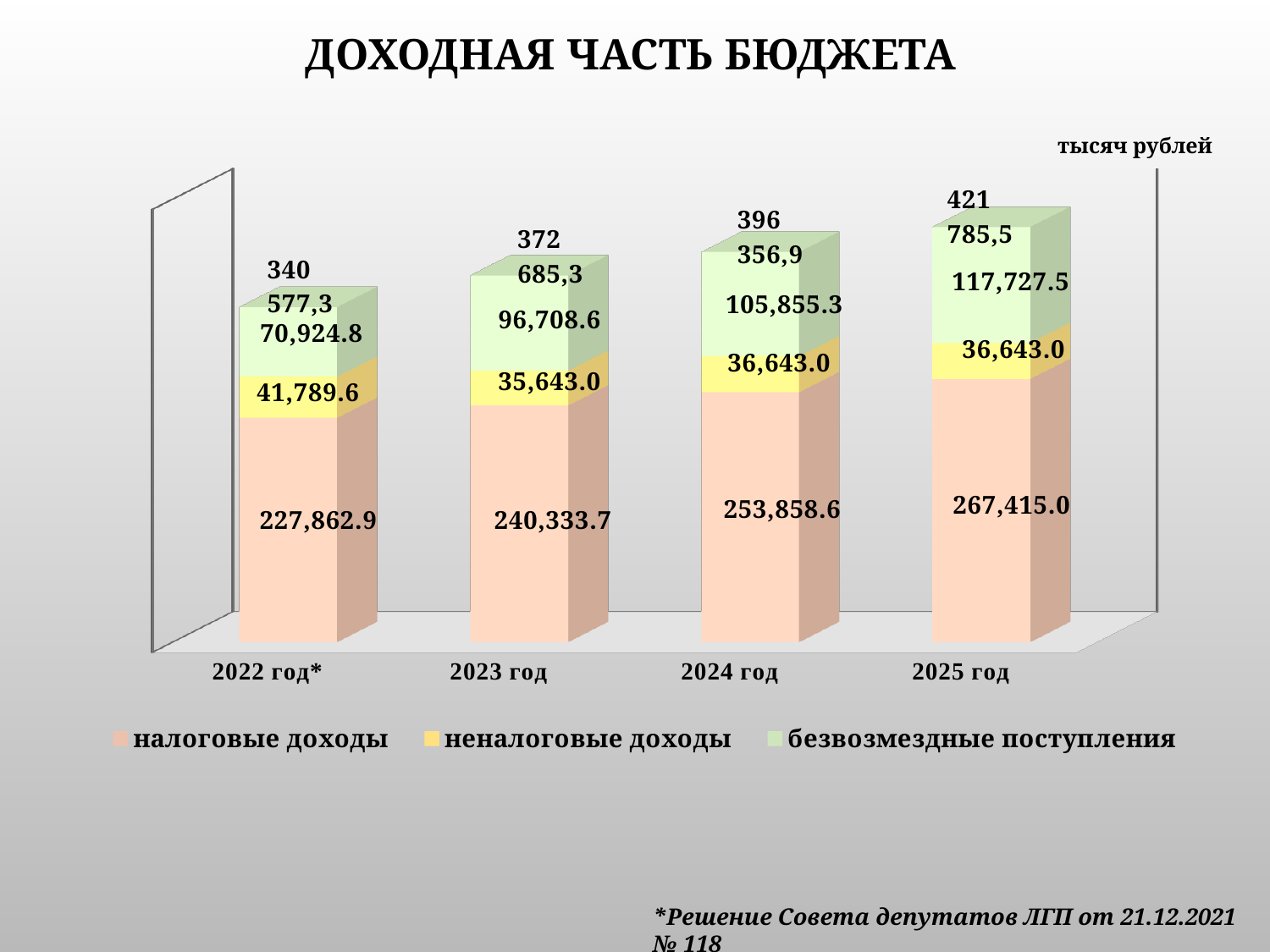
What is the value of безвозмездные поступления for 2025 год? 117,727.5 Which is larger: безвозмездные поступления in 2023 год or неналоговые доходы in 2023 год? безвозмездные поступления How many years (categories) are shown on the x axis? 4 Do the налоговые доходы values rise or fall from 2022 год* to 2025 год? rise What is the total printed above the bar for 2024 год? 396 356,9 Which year has the highest value of налоговые доходы? 2025 год What kind of chart is shown on the slide? stacked bar chart Which year has the lowest value of безвозмездные поступления? 2022 год* What is the value of налоговые доходы for 2023 год? 240,333.7 How many series does the legend list? 3 What is the difference between налоговые доходы in 2025 год and 2024 год? 13,556.4 What is the value of неналоговые доходы for 2022 год*? 41,789.6